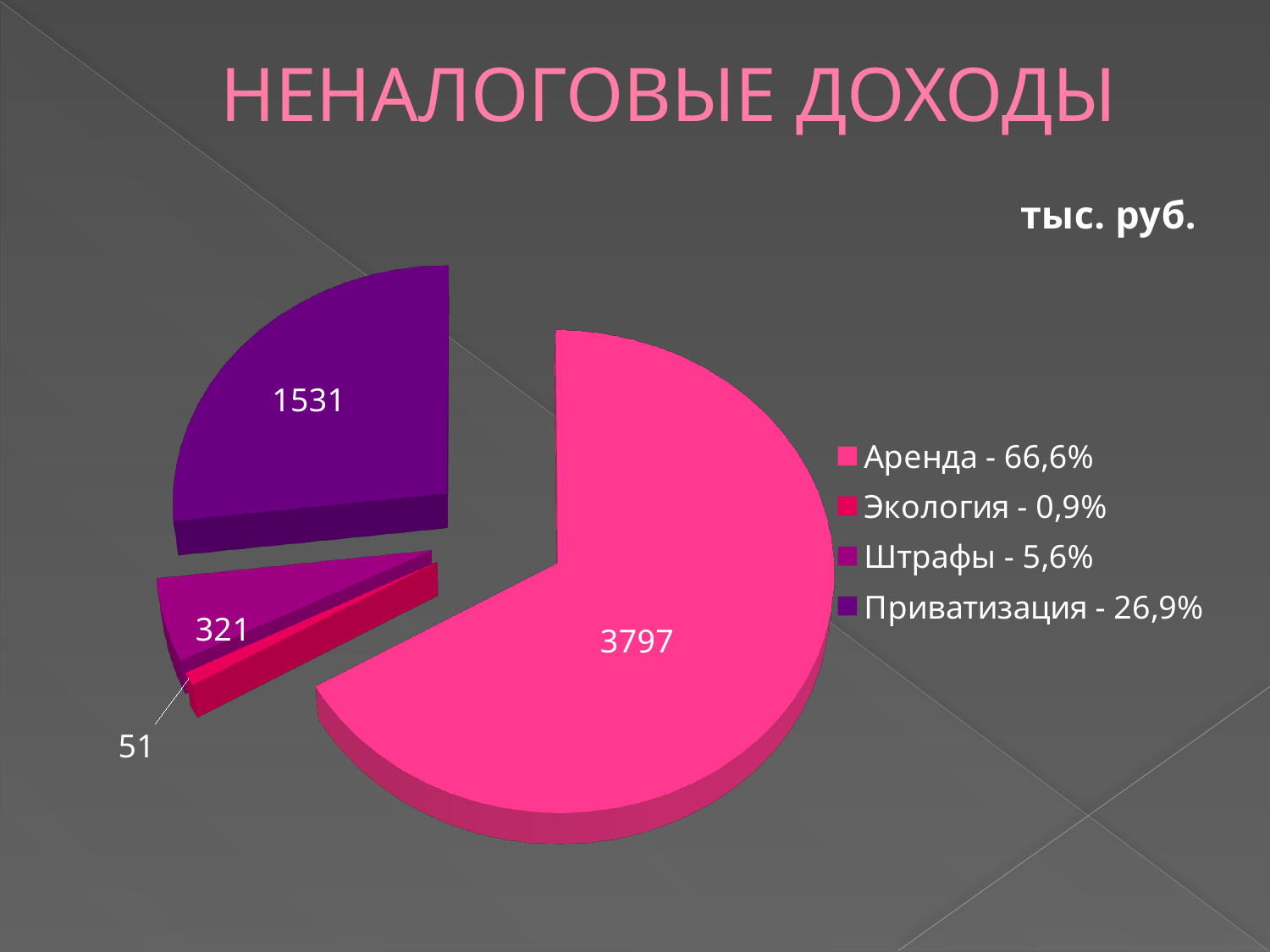
What type of chart is shown on the slide? pie chart Which category has the largest slice? Аренда What is the value for Приватизация? 1531 What is the value for Экология? 51 How many categories does the pie chart have? 4 What share of the pie does Приватизация represent? 26,9% Which category has the smallest slice? Экология What is the value for Штрафы? 321 What share of the pie does Штрафы represent? 5,6% What is the value for Аренда? 3797 What is the difference between the values for Аренда and Приватизация? 2266